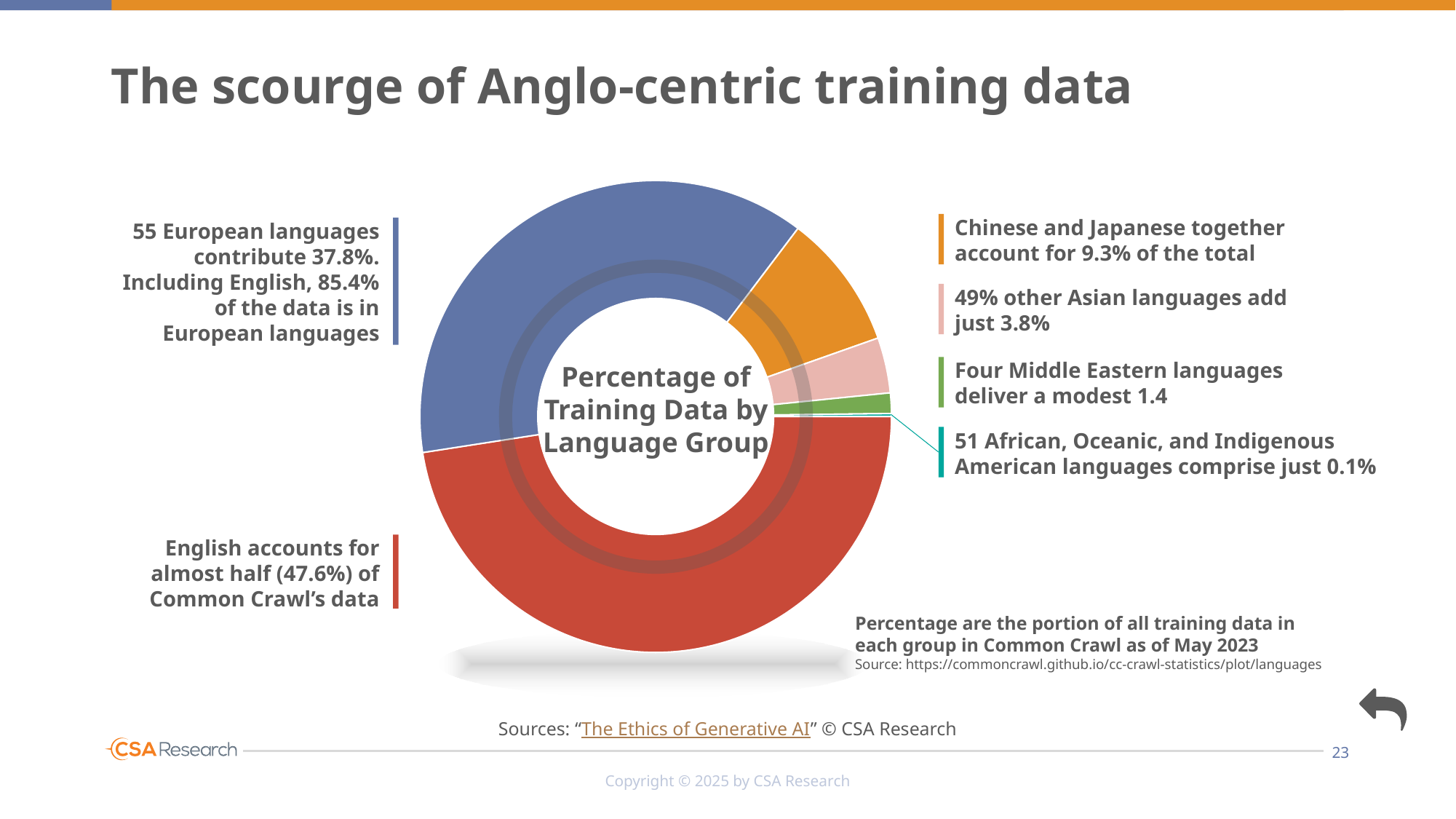
Which is larger: the share for Chinese and Japanese or the share for other Asian languages? Chinese and Japanese What is the title shown in the centre of the chart? Percentage of Training Data by Language Group What share of the total do Chinese and Japanese together account for? 9.3% Which language group has the smallest share of the training data? African, Oceanic, and Indigenous American languages What kind of chart is shown on the slide? Donut (pie) chart Which language group has the largest share of the training data? English What percentage do the 51 African, Oceanic, and Indigenous American languages comprise? 0.1% What is the difference between the English share (47.6%) and the share of the 55 other European languages (37.8%)? 9.8% What percentage of Common Crawl's data does English account for? 47.6% What percentage do the 49 other Asian languages add? 3.8% What percentage of the training data do the 55 European languages (excluding English) contribute? 37.8% How many language-group segments does the donut chart have? 6